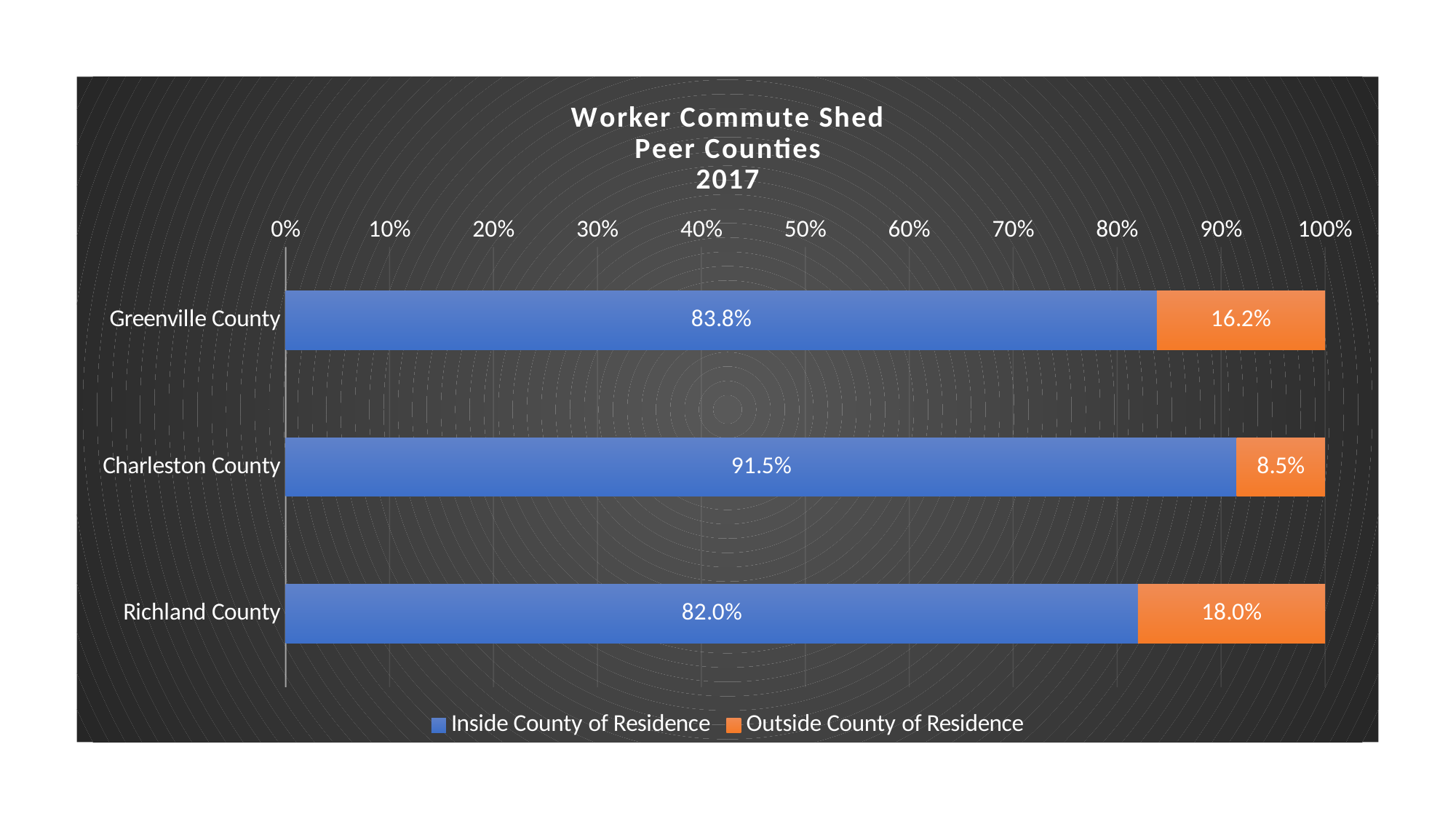
Which is larger: the Inside County of Residence value for Greenville County or for Richland County? Greenville County What is the Inside County of Residence value for Greenville County? 83.8% How many counties are shown on the chart? 3 Which county has the lowest Outside County of Residence share? Charleston County What is the Outside County of Residence value for Charleston County? 8.5% What is the Inside County of Residence value for Richland County? 82.0% What is the difference between the Outside County of Residence values for Richland County and Greenville County? 1.8% What is the title of the chart? Worker Commute Shed Peer Counties 2017 What kind of chart is shown on the slide? Stacked bar chart How many series does the legend list? 2 What is the total of the stacked bar for Charleston County? 100.0% Which county has the highest Inside County of Residence share? Charleston County